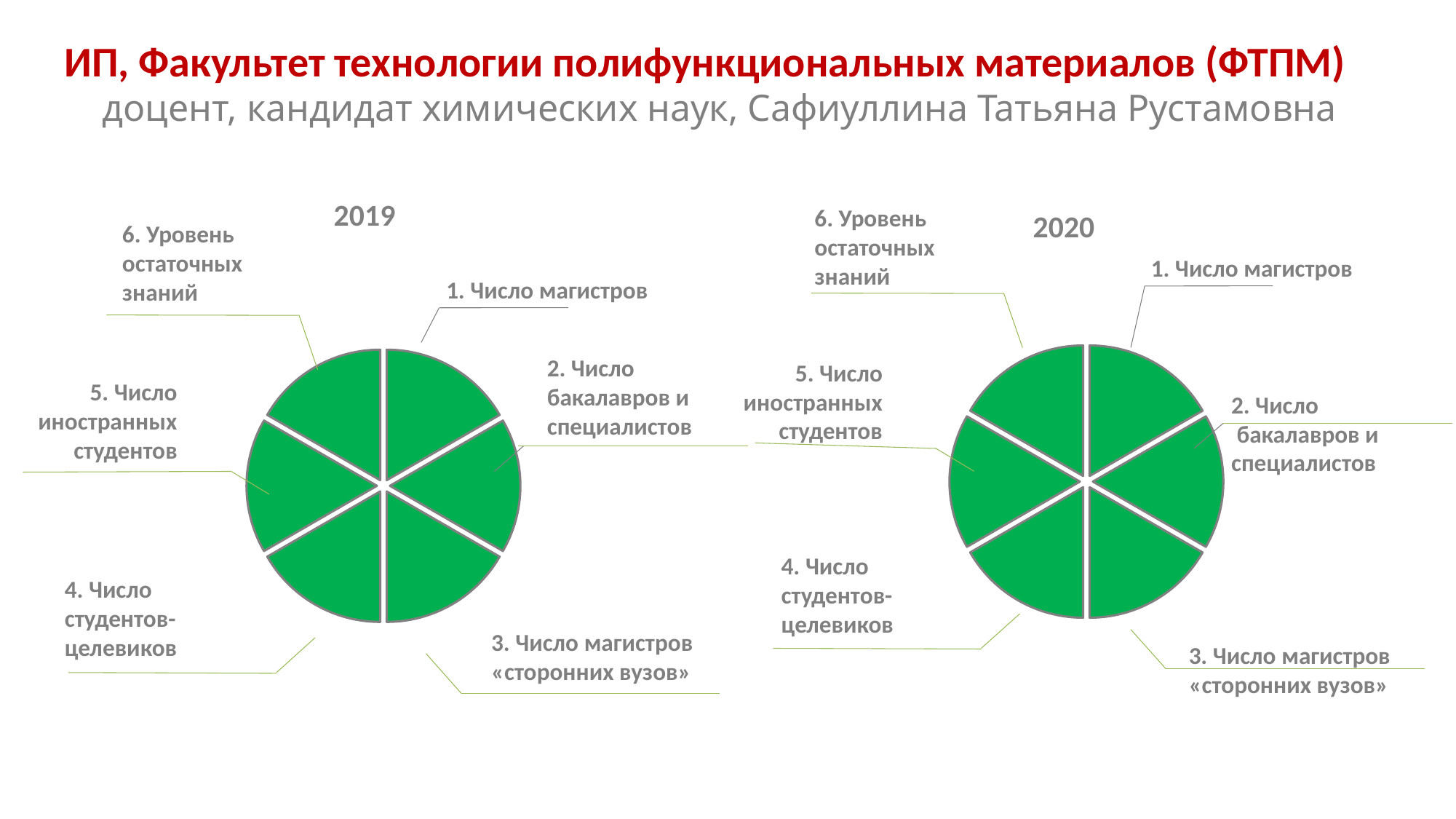
In the 2019 pie chart, what is the label of slice number 4? Число студентов-целевиков What kind of chart is the chart titled 2020? pie chart How many slices does the 2019 pie chart have? 6 What kind of chart is the chart titled 2019? pie chart In the 2020 pie chart, what is the label of slice number 3? Число магистров «сторонних вузов» In the 2019 pie chart, what is the label of slice number 1? Число магистров How many pie charts are shown on the slide? 2 In the 2020 pie chart, what is the label of slice number 6? Уровень остаточных знаний What is the title of the pie chart on the right side of the slide? 2020 What is the title of the pie chart on the left side of the slide? 2019 How many slices does the 2020 pie chart have? 6